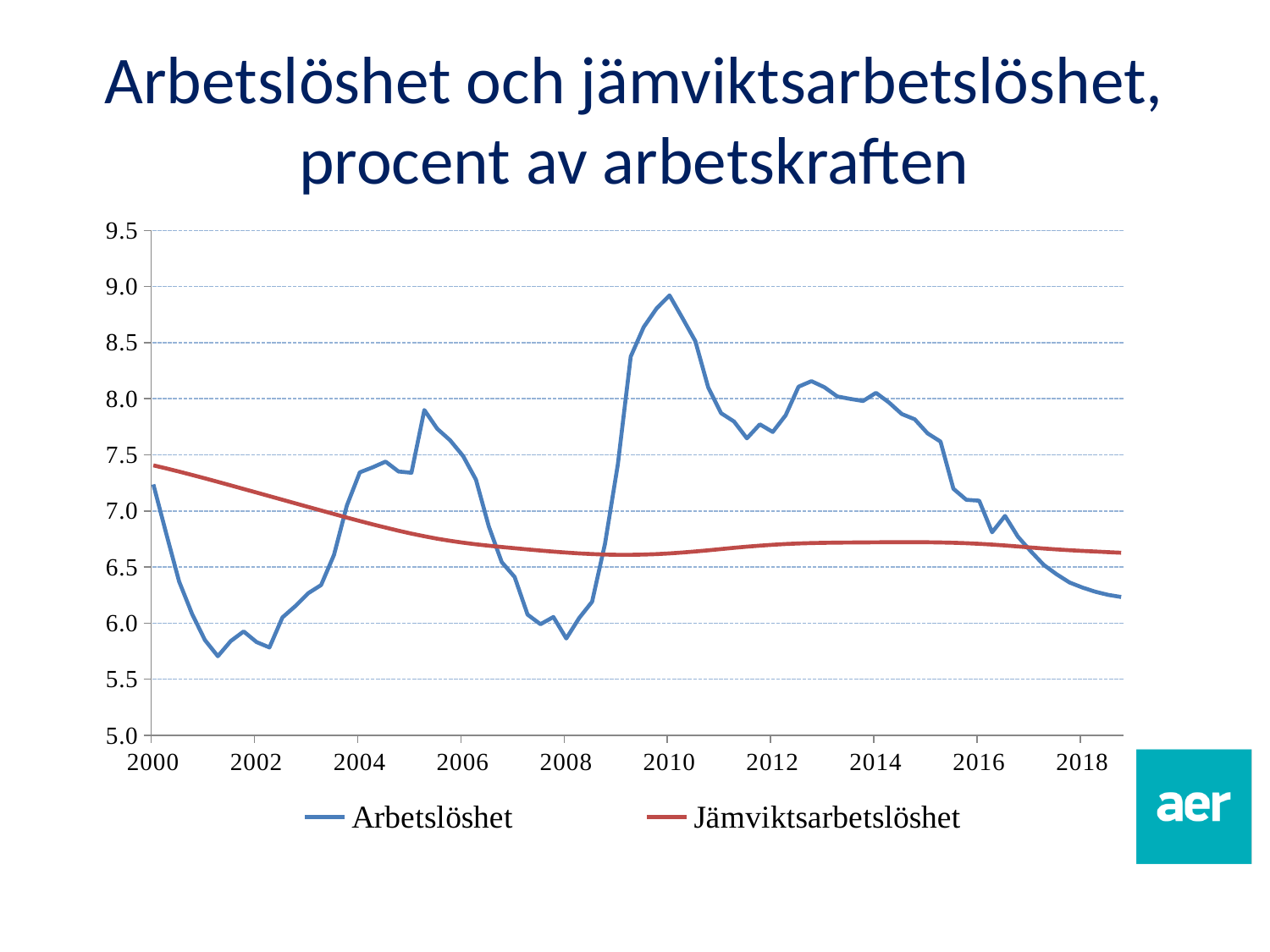
Is the value for Jämviktsarbetslöshet in 2000 greater or less than 7.0? greater How many series does the legend list? 2 Which colour is the Jämviktsarbetslöshet line? Red What are the two series named in the legend? Arbetslöshet and Jämviktsarbetslöshet Does the Jämviktsarbetslöshet line rise or fall between 2000 and 2008? Fall Is the value for Jämviktsarbetslöshet in 2018 greater or less than 7.0? less What kind of chart is shown on the slide? Line chart Is the value for Arbetslöshet in 2008 greater or less than 6.5? less In 2002, which series has the higher value, Arbetslöshet or Jämviktsarbetslöshet? Jämviktsarbetslöshet Around which year does the Arbetslöshet line reach its highest point? 2010 In 2010, which series has the higher value, Arbetslöshet or Jämviktsarbetslöshet? Arbetslöshet